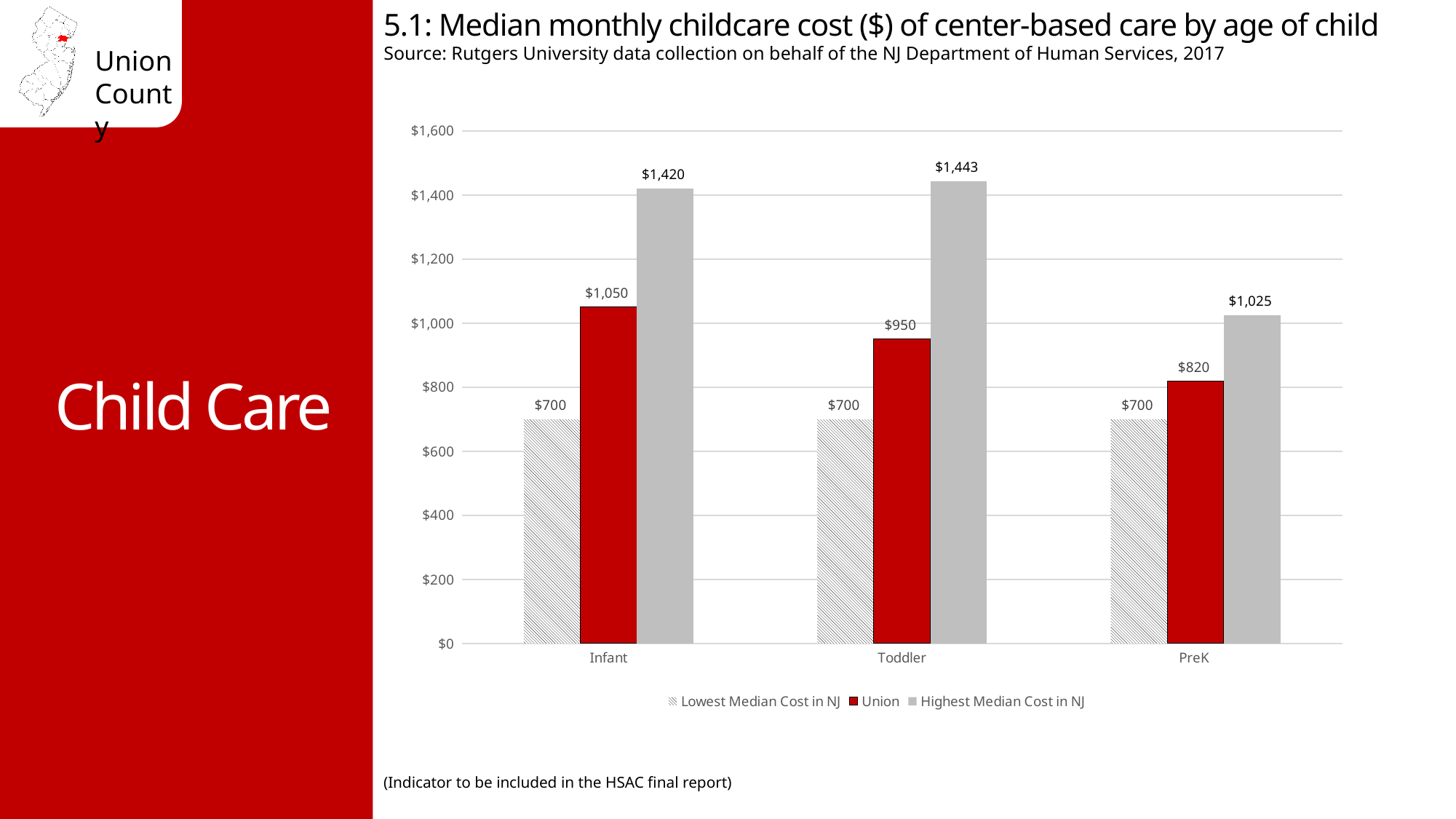
How many age groups are shown on the x axis? 3 What is the Highest Median Cost in NJ for Toddler care? $1,443 Is the Union cost for Toddler care larger or smaller than the Union cost for PreK care? larger What is the Lowest Median Cost in NJ for PreK care? $700 Do the Union values rise or fall from Infant to PreK? fall Which series is shown in red? Union Which age group has the highest Union median monthly cost? Infant What is the Union median monthly childcare cost for Infant care? $1,050 What is the difference between the Highest Median Cost in NJ and the Union cost for Infant care? $370 What kind of chart is shown on the slide? bar chart Which age group has the lowest Highest Median Cost in NJ? PreK How many series does the legend list? 3